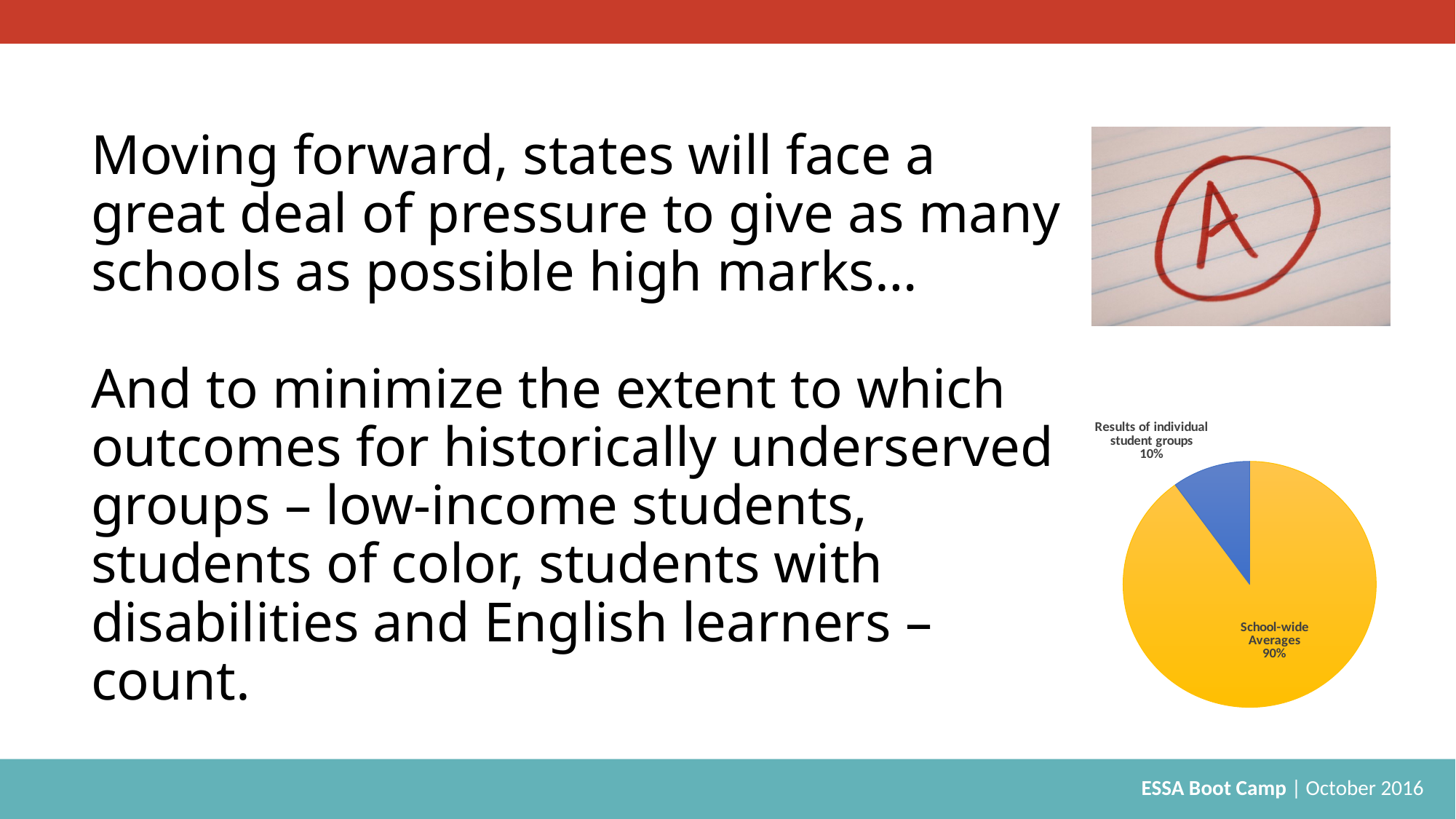
What share of the pie is labelled Results of individual student groups? 10% What colour is the School-wide Averages slice? Yellow What is the difference in percentage points between the School-wide Averages slice and the Results of individual student groups slice? 80 How many slices does the pie chart have? 2 Which is larger: the School-wide Averages slice or the Results of individual student groups slice? School-wide Averages What kind of chart is shown on the slide? Pie chart Which slice of the pie is the smallest? Results of individual student groups Which slice of the pie is the largest? School-wide Averages What share of the pie is labelled School-wide Averages? 90% What colour is the Results of individual student groups slice? Blue